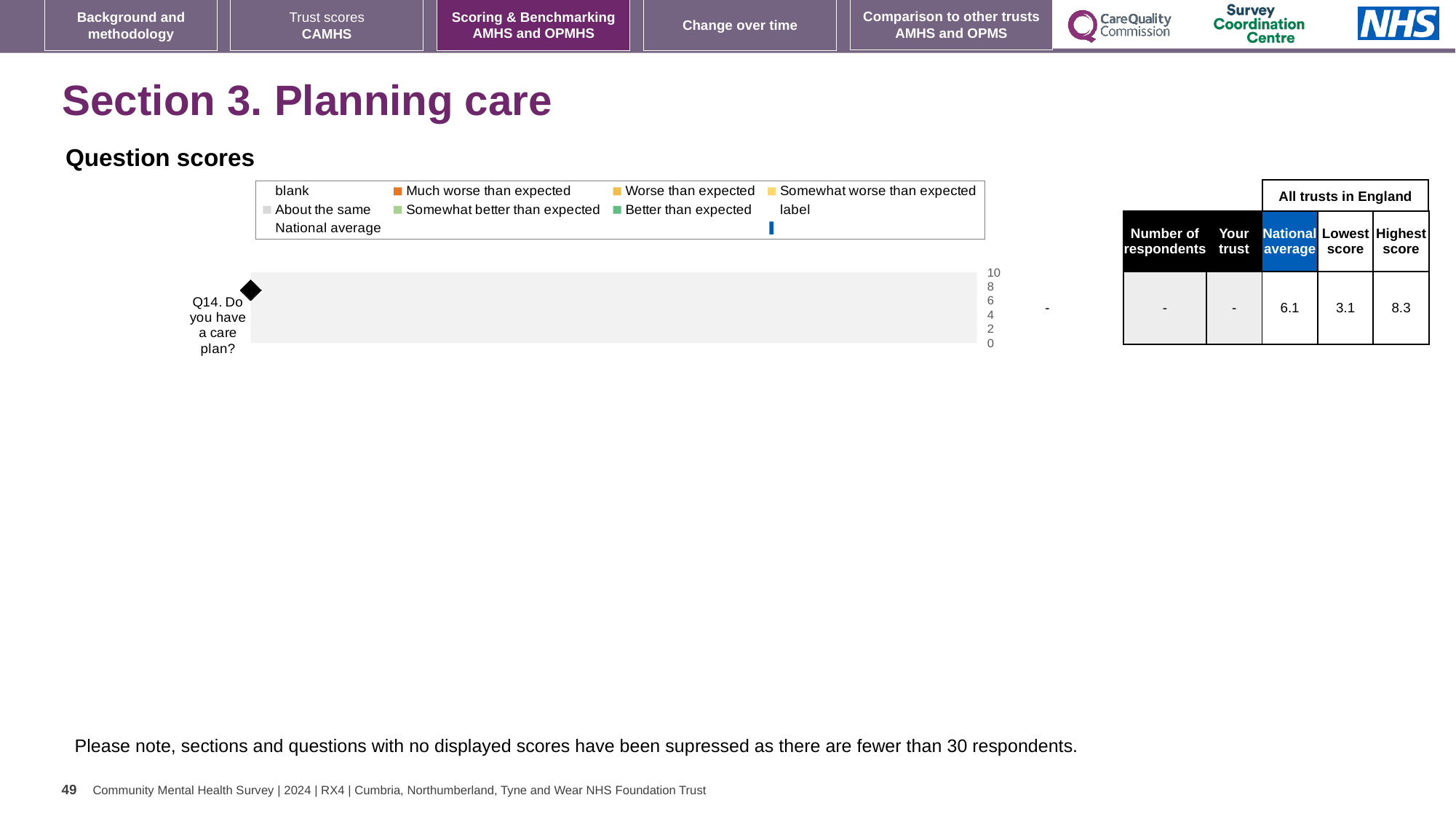
In the table next to the chart, what is the difference between the highest score and the lowest score for Q14? 5.2 How many question categories are plotted on the chart? 1 In the table next to the chart, what is the highest score across all trusts in England for Q14? 8.3 In the table next to the chart, which is larger for Q14: the national average or the lowest score? national average In the table next to the chart, what is the national average score for Q14? 6.1 What data label is displayed for Q14 on the chart? - What is the label of the single category on the chart? Q14. Do you have a care plan? What is the highest value shown on the chart's axis? 10 What kind of chart is shown under 'Question scores'? bar chart In the table next to the chart, what is the lowest score across all trusts in England for Q14? 3.1 In the table next to the chart, what is shown for 'Your trust' for Q14? -